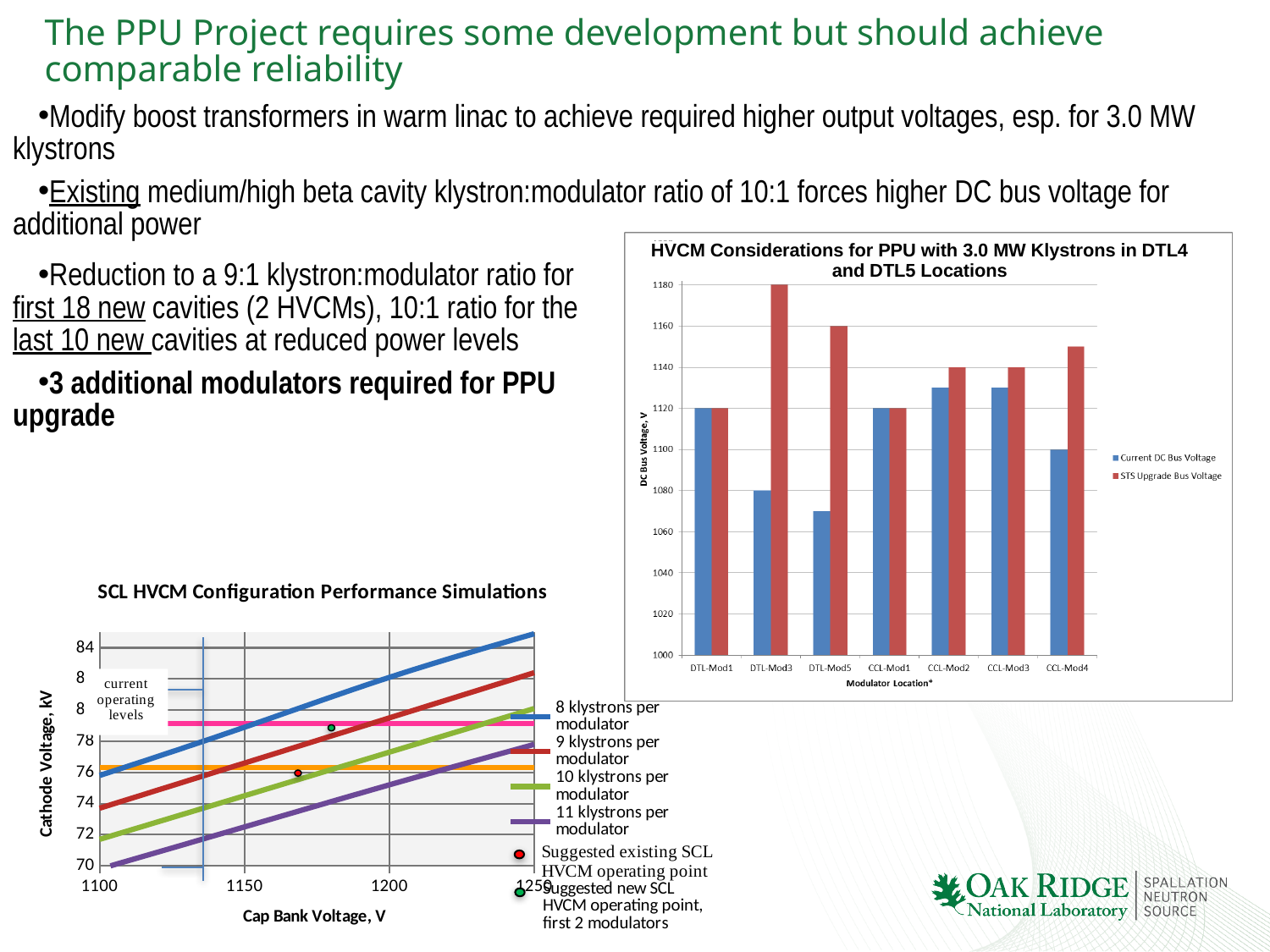
In the bar chart titled 'HVCM Considerations for PPU with 3.0 MW Klystrons in DTL4 and DTL5 Locations', which modulator location has the highest STS Upgrade Bus Voltage? DTL-Mod3 In the 'SCL HVCM Configuration Performance Simulations' chart, does the '9 klystrons per modulator' line rise or fall as Cap Bank Voltage increases? Rises In the bar chart titled 'HVCM Considerations for PPU with 3.0 MW Klystrons in DTL4 and DTL5 Locations', how many modulator locations are shown on the x axis? 7 In the bar chart titled 'HVCM Considerations for PPU with 3.0 MW Klystrons in DTL4 and DTL5 Locations', which modulator location has the lowest Current DC Bus Voltage? DTL-Mod5 In the bar chart titled 'HVCM Considerations for PPU with 3.0 MW Klystrons in DTL4 and DTL5 Locations', what is the STS Upgrade Bus Voltage for DTL-Mod5? 1160 What kind of chart is the 'SCL HVCM Configuration Performance Simulations' chart at the bottom left of the slide? Line chart In the bar chart titled 'HVCM Considerations for PPU with 3.0 MW Klystrons in DTL4 and DTL5 Locations', what is the Current DC Bus Voltage for DTL-Mod3? 1080 In the bar chart titled 'HVCM Considerations for PPU with 3.0 MW Klystrons in DTL4 and DTL5 Locations', what is the difference between the STS Upgrade Bus Voltage and the Current DC Bus Voltage for DTL-Mod3? 100 In the bar chart titled 'HVCM Considerations for PPU with 3.0 MW Klystrons in DTL4 and DTL5 Locations', is the STS Upgrade Bus Voltage for CCL-Mod4 greater or less than 1140? greater In the bar chart titled 'HVCM Considerations for PPU with 3.0 MW Klystrons in DTL4 and DTL5 Locations', what is the STS Upgrade Bus Voltage for DTL-Mod3? 1180 In the bar chart titled 'HVCM Considerations for PPU with 3.0 MW Klystrons in DTL4 and DTL5 Locations', is the Current DC Bus Voltage for DTL-Mod5 greater or less than 1080? less In the bar chart titled 'HVCM Considerations for PPU with 3.0 MW Klystrons in DTL4 and DTL5 Locations', how many series does the legend list? 2